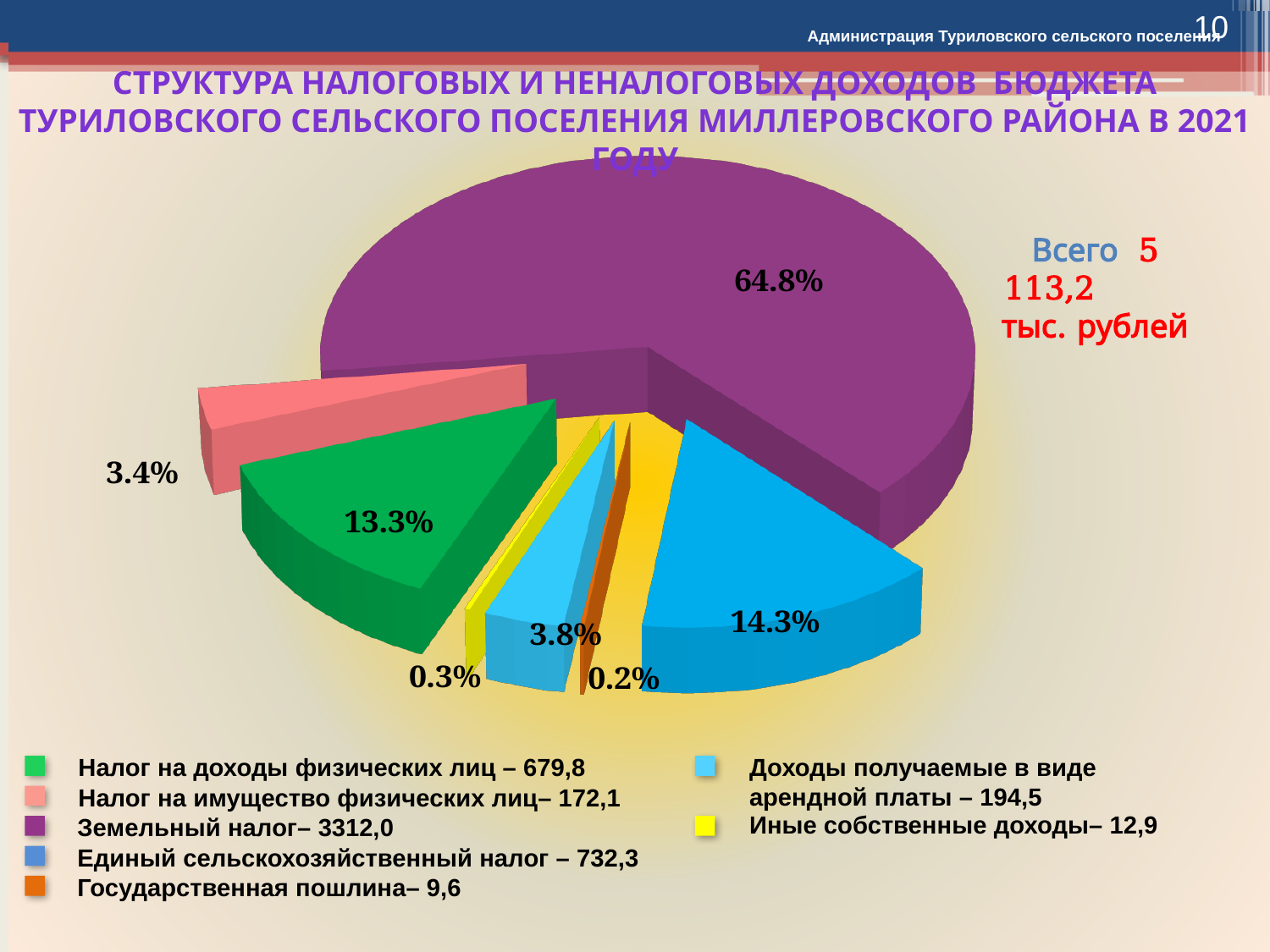
What value does the legend give for Земельный налог? 3312,0 What percentage is shown for the Доходы получаемые в виде арендной платы (light blue) slice? 3.8% What kind of chart is shown on the slide? pie chart Which is larger: the Налог на имущество физических лиц slice or the Доходы получаемые в виде арендной платы slice? Доходы получаемые в виде арендной платы What percentage is shown for the Единый сельскохозяйственный налог (blue) slice? 14.3% What share of the pie does the Земельный налог (purple) slice have? 64.8% Which category has the smallest slice of the pie? Государственная пошлина What is the difference in percentage points between the Единый сельскохозяйственный налог slice (14.3%) and the Налог на доходы физических лиц slice (13.3%)? 1.0 percentage point How many categories does the pie chart legend list? 7 What percentage is shown for the Налог на доходы физических лиц (green) slice? 13.3% Which category has the largest slice of the pie? Земельный налог What total amount (Всего) is stated next to the pie chart? 5 113,2 тыс. рублей